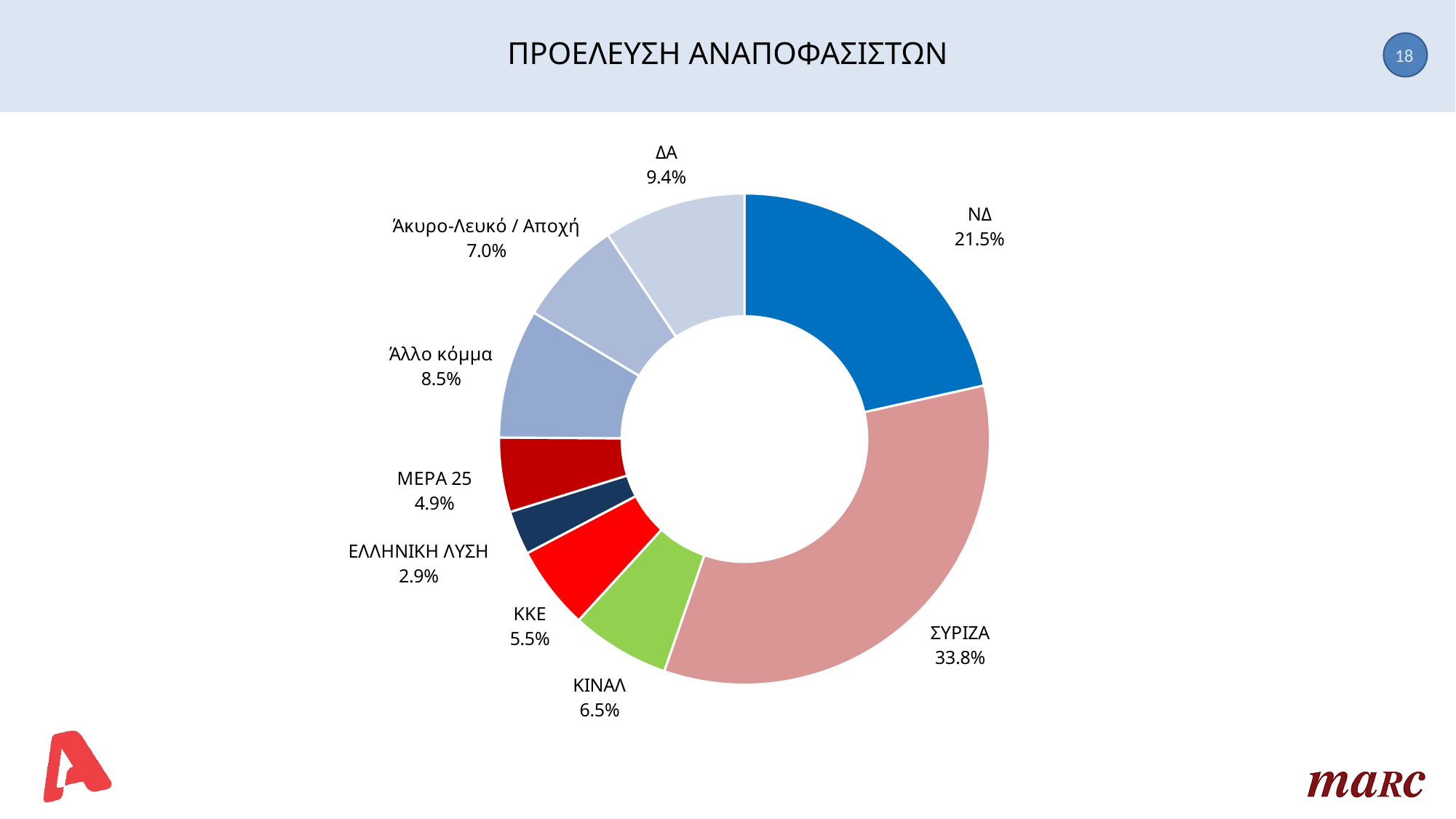
What percentage is shown for ΕΛΛΗΝΙΚΗ ΛΥΣΗ? 2.9% What is the title of the slide? ΠΡΟΕΛΕΥΣΗ ΑΝΑΠΟΦΑΣΙΣΤΩΝ What percentage is shown for ΚΙΝΑΛ? 6.5% Which is larger, the share for ΔΑ or the share for Άλλο κόμμα? ΔΑ Which is larger, the share for ΚΚΕ or the share for ΜΕΡΑ 25? ΚΚΕ What percentage is shown for ΝΔ? 21.5% What percentage is shown for ΣΥΡΙΖΑ? 33.8% What kind of chart is shown on the slide? Doughnut (pie) chart How many categories are shown in the chart? 9 Which category has the largest share of the chart? ΣΥΡΙΖΑ Which category has the smallest share of the chart? ΕΛΛΗΝΙΚΗ ΛΥΣΗ What is the difference in percentage points between ΣΥΡΙΖΑ and ΝΔ? 12.3